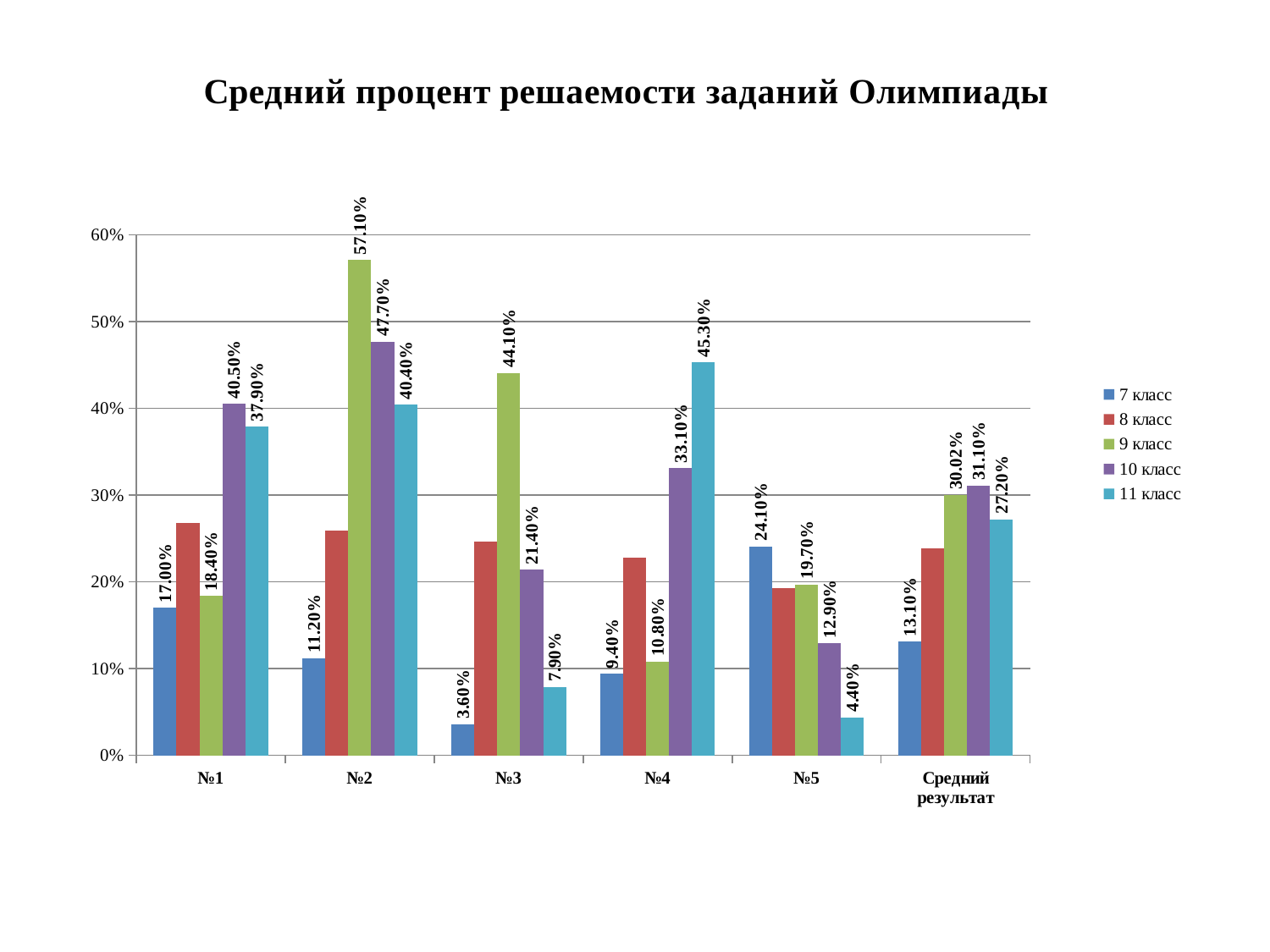
How many series does the legend list? 5 What is the value for 9 класс on task №2? 57.10% Is the value for 8 класс on task №1 greater or less than 20%? greater How many categories are shown on the x axis? 6 On which task does 7 класс have its lowest value? №3 What is the title of the chart? Средний процент решаемости заданий Олимпиады What is the value for 10 класс in the Средний результат category? 31.10% What is the value for 11 класс on task №4? 45.30% What kind of chart is shown on the slide? bar chart On task №5, which is larger: the value for 7 класс or for 9 класс? 7 класс What is the difference between the values for 10 класс and 11 класс on task №1? 2.60% Which class has the highest value on task №2? 9 класс